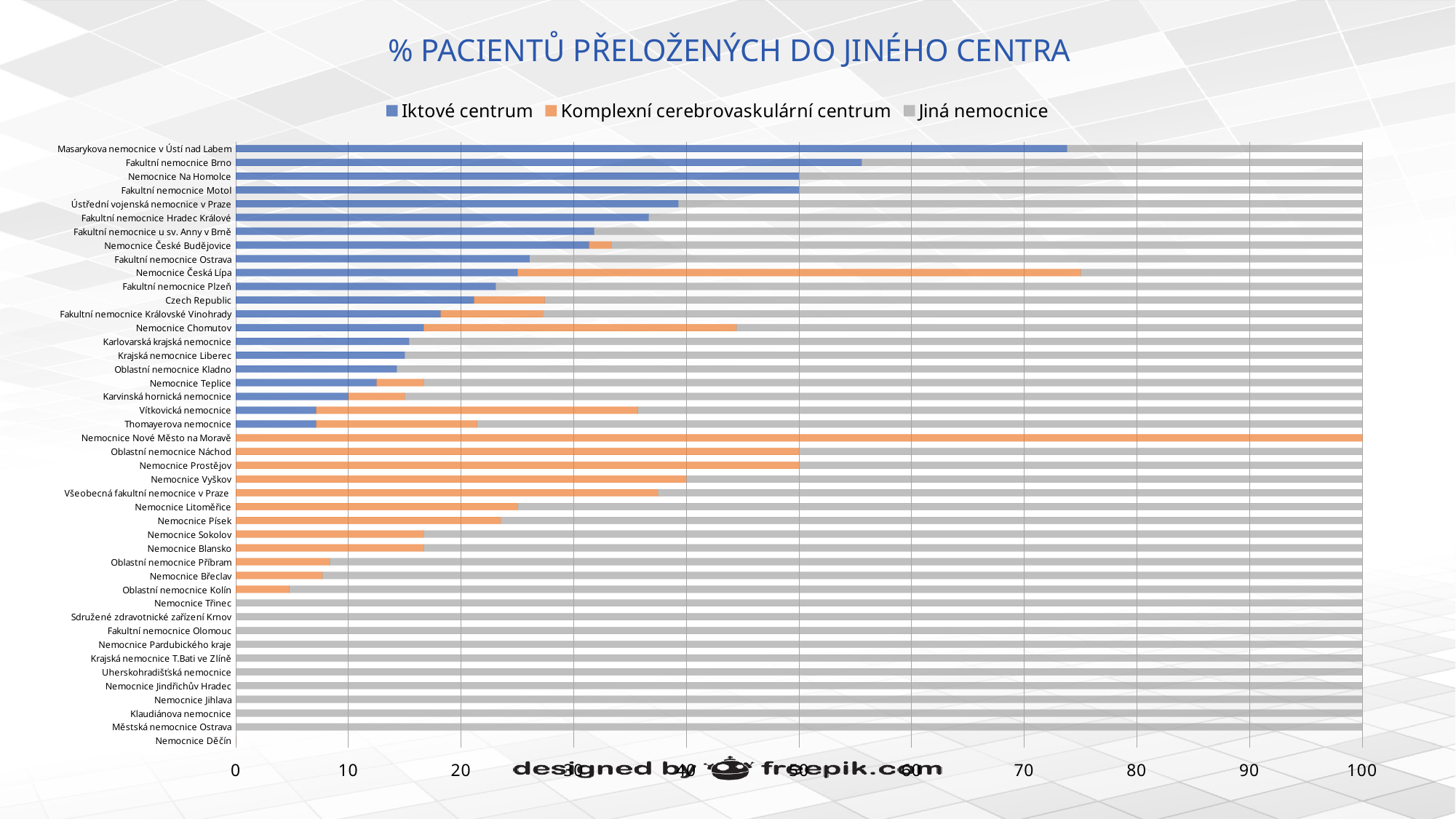
Which hospital has the highest value for Iktové centrum? Masarykova nemocnice v Ústí nad Labem What are the three series named in the legend? Iktové centrum, Komplexní cerebrovaskulární centrum, Jiná nemocnice How many series does the legend list? 3 Is the Iktové centrum value for Masarykova nemocnice v Ústí nad Labem greater or less than 70? greater Which hospital has the highest value for Komplexní cerebrovaskulární centrum? Nemocnice Nové Město na Moravě Is the Komplexní cerebrovaskulární centrum value for Oblastní nemocnice Kolín greater or less than 10? less How many hospitals (categories) are listed on the vertical axis? 44 What is the Komplexní cerebrovaskulární centrum value for Nemocnice Nové Město na Moravě? 100 For Nemocnice Česká Lípa, which is larger: the Iktové centrum value or the Komplexní cerebrovaskulární centrum value? Komplexní cerebrovaskulární centrum What is the title of the chart? % PACIENTŮ PŘELOŽENÝCH DO JINÉHO CENTRA What kind of chart is shown on the slide? bar chart Which has the larger Iktové centrum value: Fakultní nemocnice Brno or Nemocnice Na Homolce? Fakultní nemocnice Brno